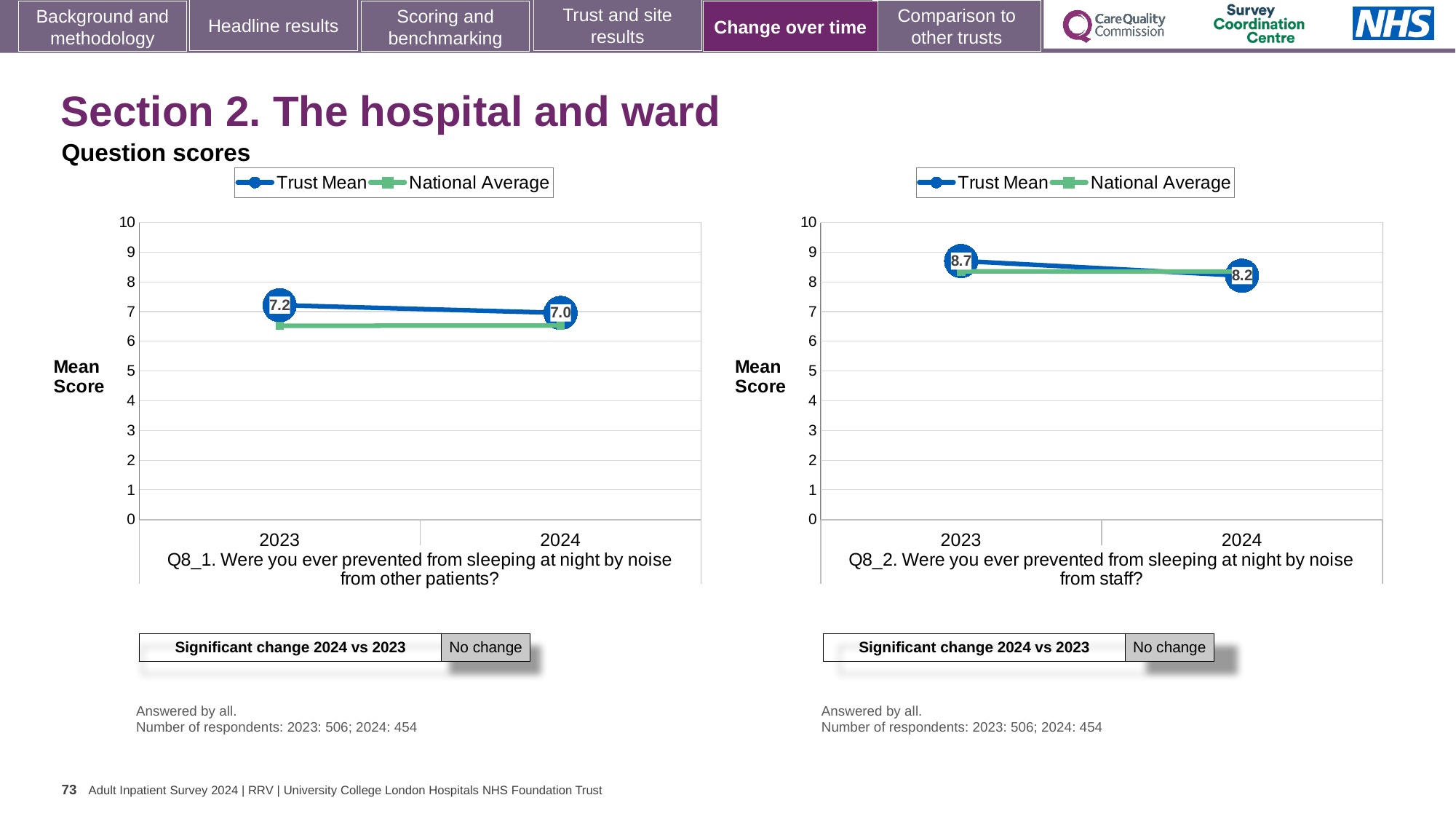
In the left chart (Q8_1, noise from other patients), what is the difference between the Trust Mean in 2023 and 2024? 0.2 In the left chart (Q8_1, noise from other patients), does the Trust Mean rise or fall from 2023 to 2024? fall In the left chart (Q8_1, noise from other patients), is the National Average for 2024 greater or less than 7? less In the left chart (Q8_1, noise from other patients), what is the Trust Mean for 2023? 7.2 What kind of chart is the left chart (Q8_1, noise from other patients)? line chart How many series does the legend of the right chart (Q8_2, noise from staff) list? 2 In the right chart (Q8_2, noise from staff), what is the Trust Mean for 2023? 8.7 How many years are plotted on the x axis of the right chart (Q8_2, noise from staff)? 2 In the right chart (Q8_2, noise from staff), is the Trust Mean for 2023 greater or less than the National Average for 2023? greater In the left chart (Q8_1, noise from other patients), what is the Trust Mean for 2024? 7.0 In the right chart (Q8_2, noise from staff), what is the Trust Mean for 2024? 8.2 In the right chart (Q8_2, noise from staff), by how much did the Trust Mean fall from 2023 to 2024? 0.5